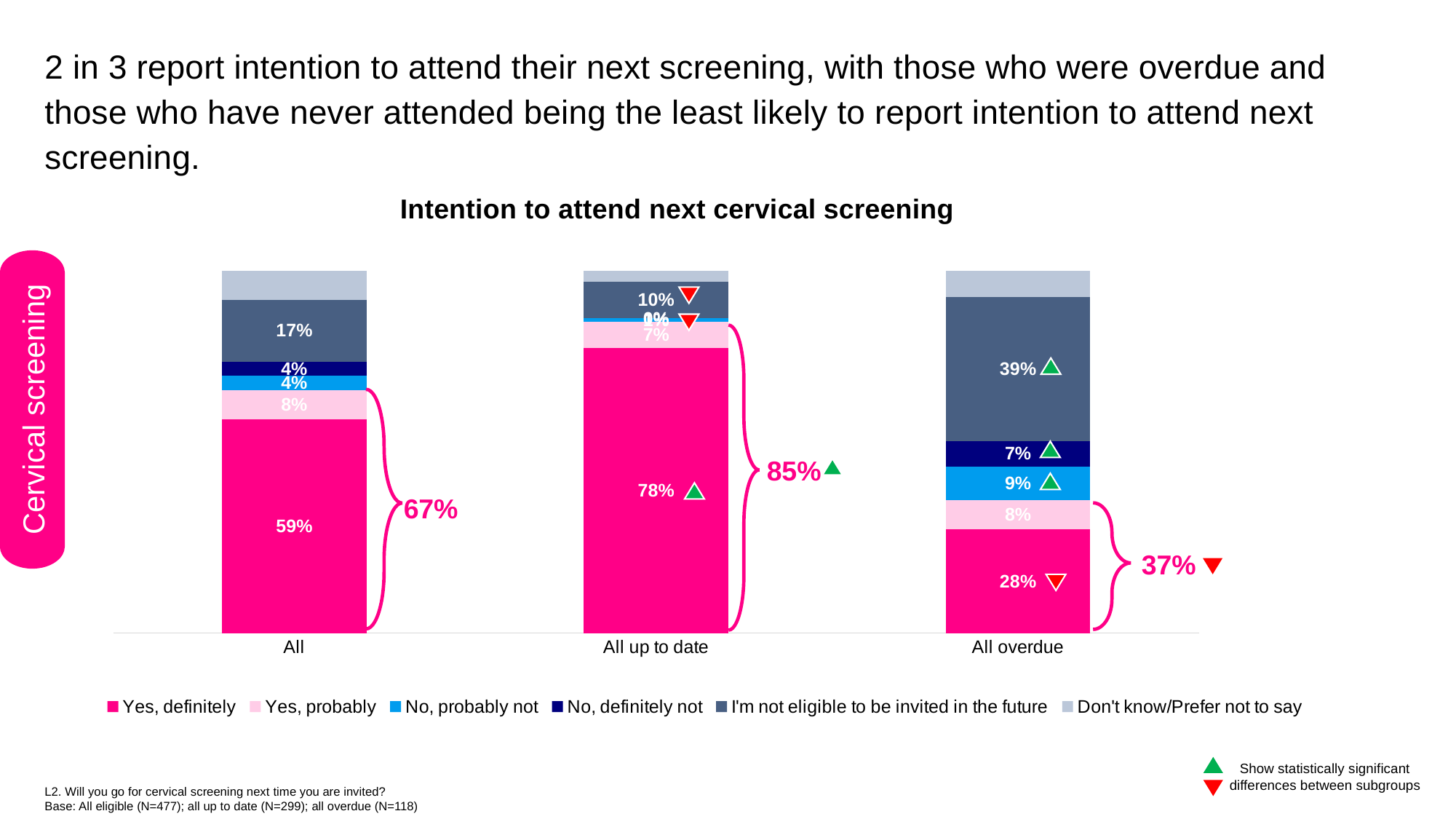
What kind of chart is shown on the slide? Stacked bar chart What is the 'Yes, definitely' value for the 'All' category? 59% How many categories are shown along the x axis of the chart? 3 Which category has the lowest 'Yes, definitely' value? All overdue What is the 'I'm not eligible to be invited in the future' value for the 'All' category? 17% What is the title of the chart? Intention to attend next cervical screening How many series does the chart's legend list? 6 What is the difference between the 'Yes, definitely' values for 'All up to date' and 'All overdue'? 50 percentage points What is the 'Yes, definitely' value for the 'All up to date' category? 78% Which category has the highest 'Yes, definitely' value? All up to date What is the 'I'm not eligible to be invited in the future' value for the 'All overdue' category? 39% What is the 'Yes, definitely' value for the 'All overdue' category? 28%